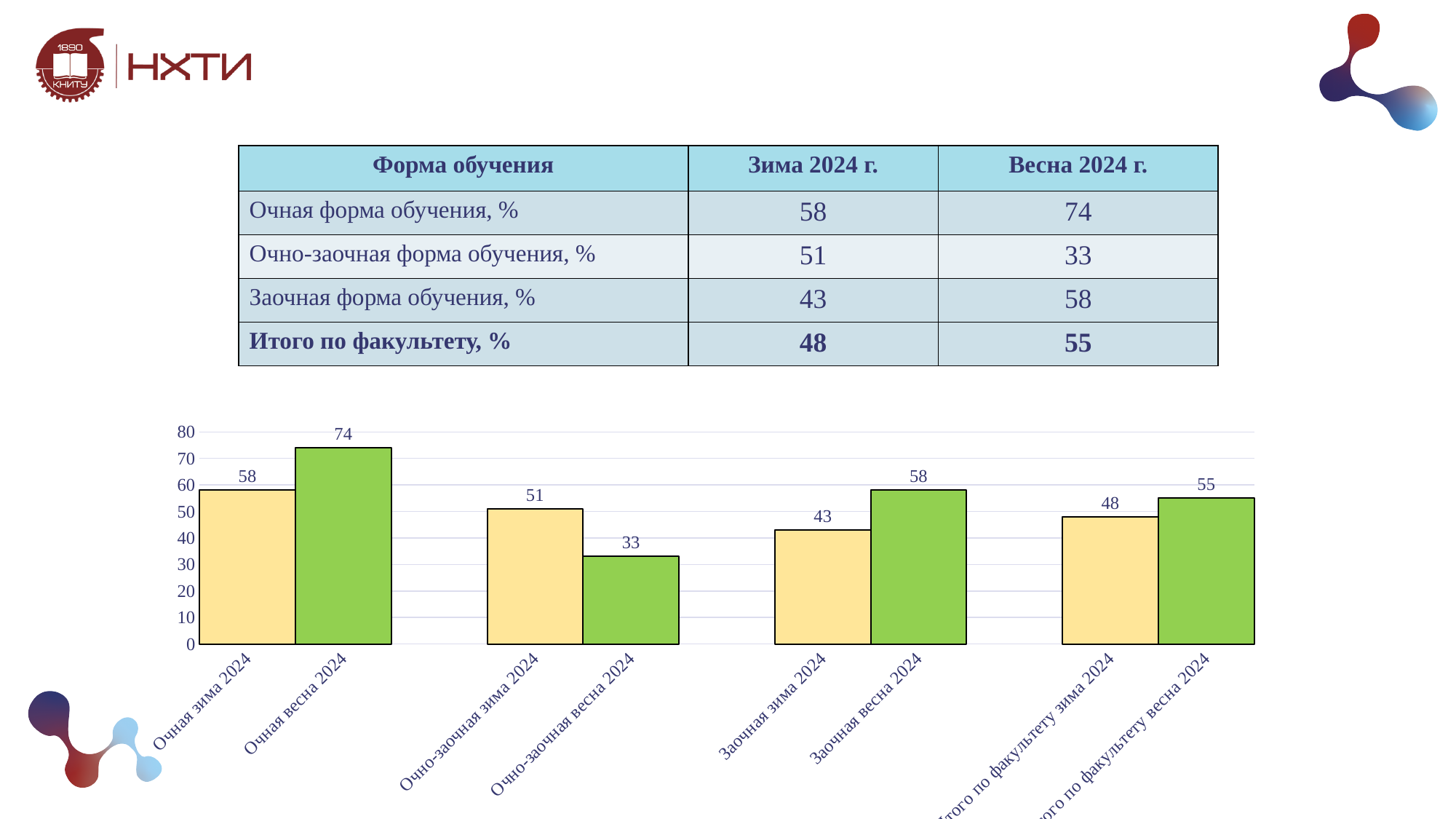
What is the value of the bar labelled "Заочная зима 2024"? 43 What is the difference between the values for "Очно-заочная зима 2024" and "Очно-заочная весна 2024"? 18 What is the difference between the values for "Очная весна 2024" and "Очная зима 2024"? 16 What type of chart is shown on the slide? bar chart What is the value of the bar labelled "Очная весна 2024"? 74 What is the highest value shown on the vertical axis of the chart? 80 What is the value of the bar labelled "Очно-заочная весна 2024"? 33 Which is larger: the value for "Заочная зима 2024" or "Заочная весна 2024"? Заочная весна 2024 Which bar has the highest value in the chart? Очная весна 2024 Which bar has the lowest value in the chart? Очно-заочная весна 2024 What is the value of the bar labelled "Итого по факультету весна 2024"? 55 How many bars are plotted in the chart? 8